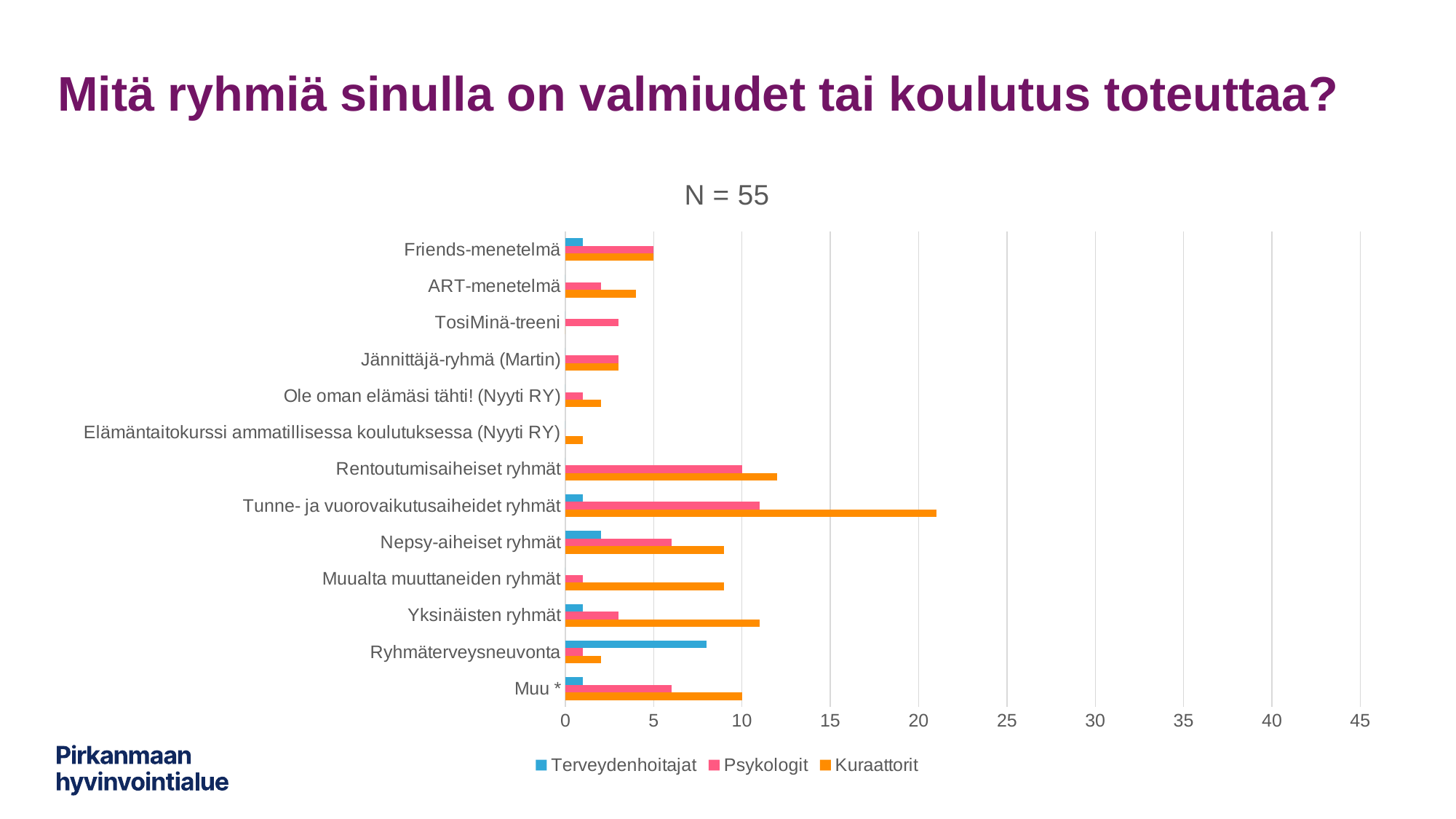
Which category has the highest value for Terveydenhoitajat? Ryhmäterveysneuvonta What is the value for Kuraattorit in the Muu * category? 10 What is the value for Psykologit in the Friends-menetelmä category? 5 What is the value for Psykologit in the Rentoutumisaiheiset ryhmät category? 10 How many series does the legend list? 3 What kind of chart is shown on the slide? bar chart Is the value for Kuraattorit in Tunne- ja vuorovaikutusaiheidet ryhmät greater or less than 15? greater Which category has the highest value for Kuraattorit? Tunne- ja vuorovaikutusaiheidet ryhmät Which series is shown in orange in the legend? Kuraattorit What is the chart's title text above the plot area? N = 55 How many categories are shown on the vertical axis of the chart? 13 In the Ryhmäterveysneuvonta category, which series has the larger value, Terveydenhoitajat or Kuraattorit? Terveydenhoitajat